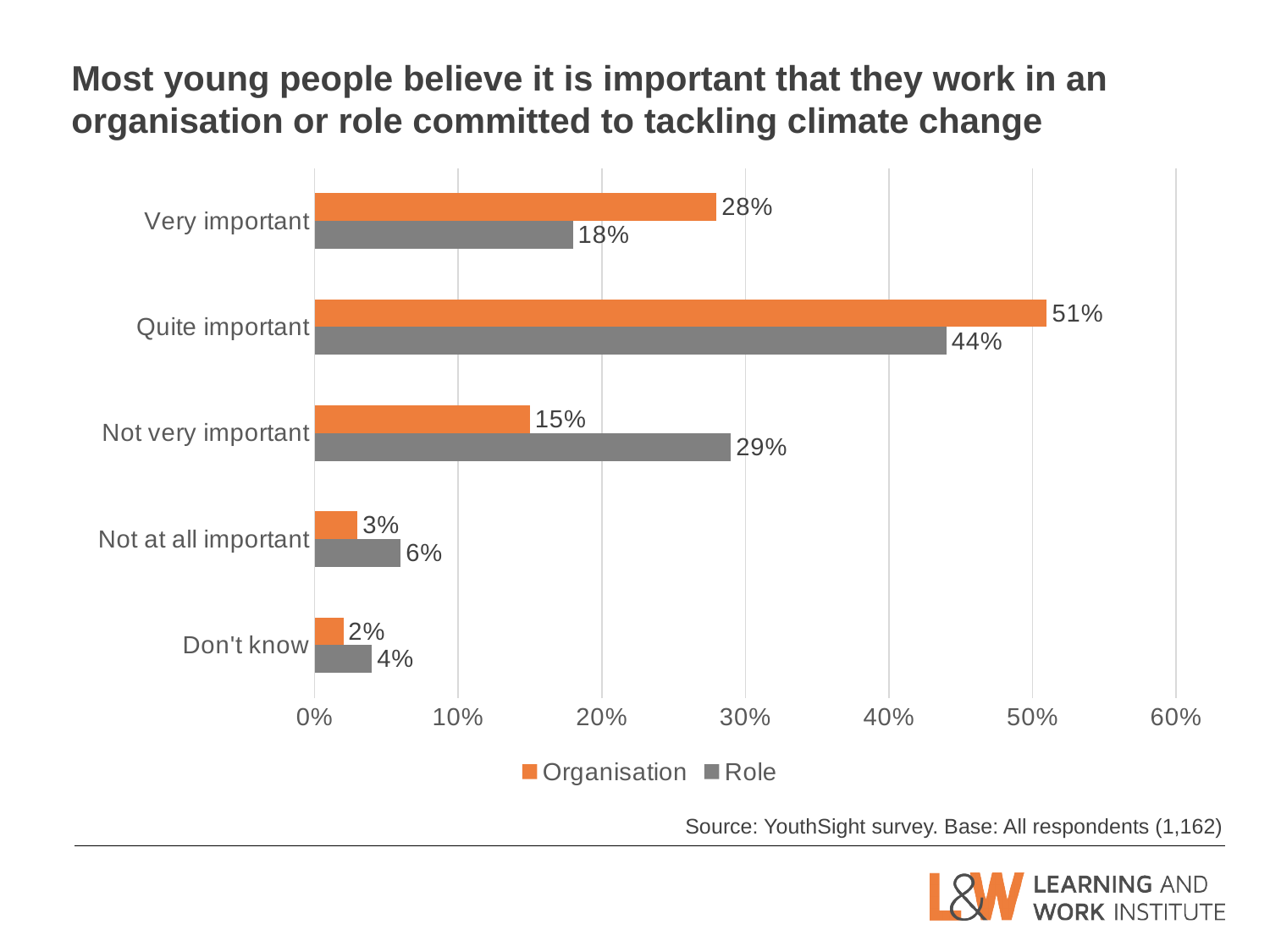
What kind of chart is shown on the slide? Bar chart Which colour represents the Organisation series? Orange How many series does the legend list? 2 What is the Role value for Very important? 18% What is the difference between the Organisation and Role values for Very important? 10% Which category has the lowest Role value? Don't know What is the Role value for Not very important? 29% How many categories are shown on the chart? 5 What is the Organisation value for Quite important? 51% What is the difference between the Role and Organisation values for Not very important? 14% Which is larger for Not at all important: the Organisation value or the Role value? Role Which category has the highest Organisation value? Quite important